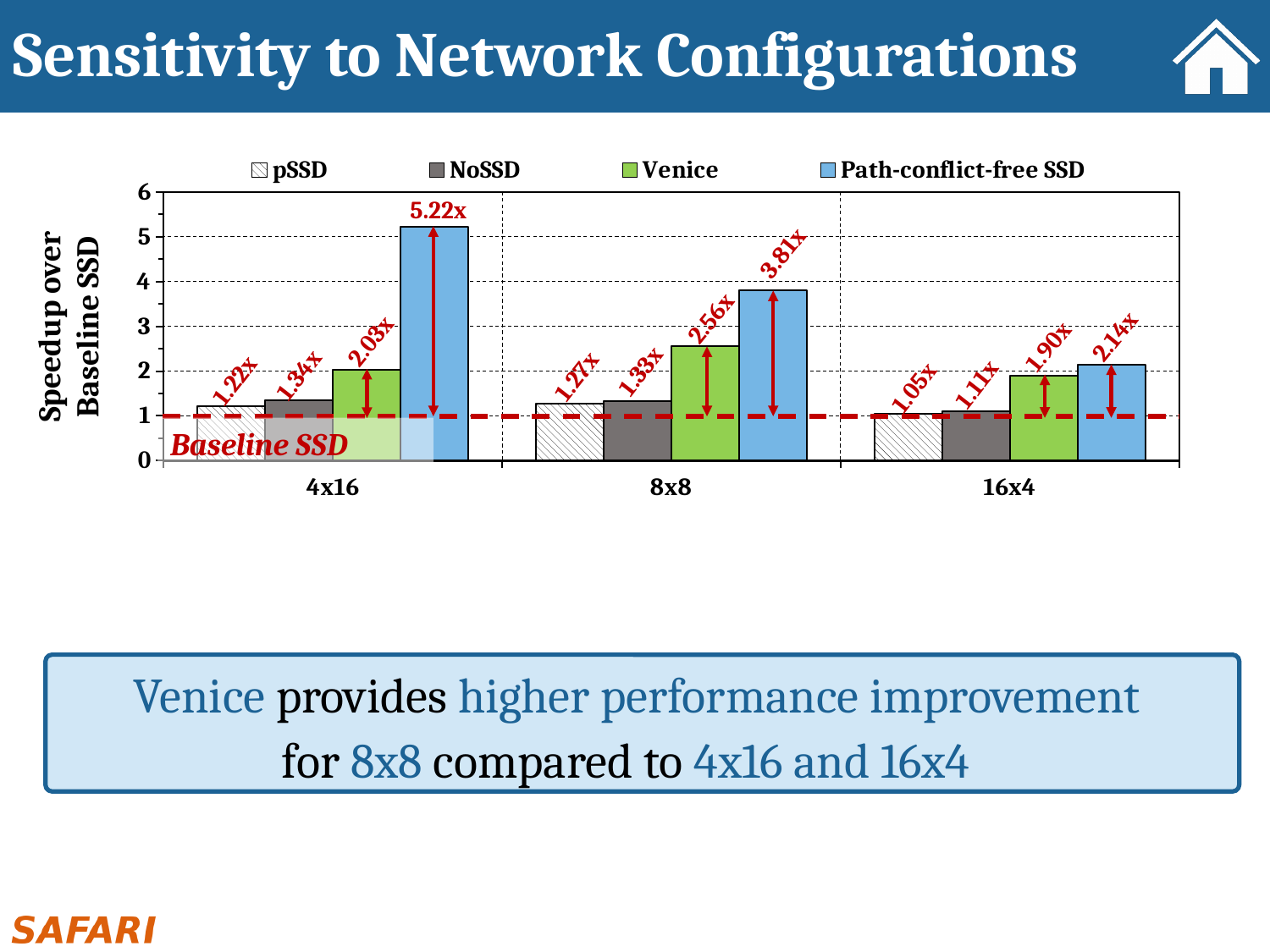
How many series does the legend list? 4 What is the difference between the Path-conflict-free SSD speedup and the Venice speedup for the 4x16 configuration? 3.19x What is the speedup of Venice for the 8x8 configuration? 2.56x Which is larger: the Venice speedup for 16x4 or the Venice speedup for 4x16? Venice speedup for 4x16 Which network configuration has the highest Venice speedup? 8x8 What is the speedup of Path-conflict-free SSD for the 4x16 configuration? 5.22x Is the Path-conflict-free SSD speedup for 8x8 greater or less than 3? greater What kind of chart is shown on the slide? Bar chart What is the speedup of NoSSD for the 8x8 configuration? 1.33x What is the speedup of pSSD for the 16x4 configuration? 1.05x Which network configuration has the lowest Path-conflict-free SSD speedup? 16x4 How many network configurations are shown on the x axis? 3